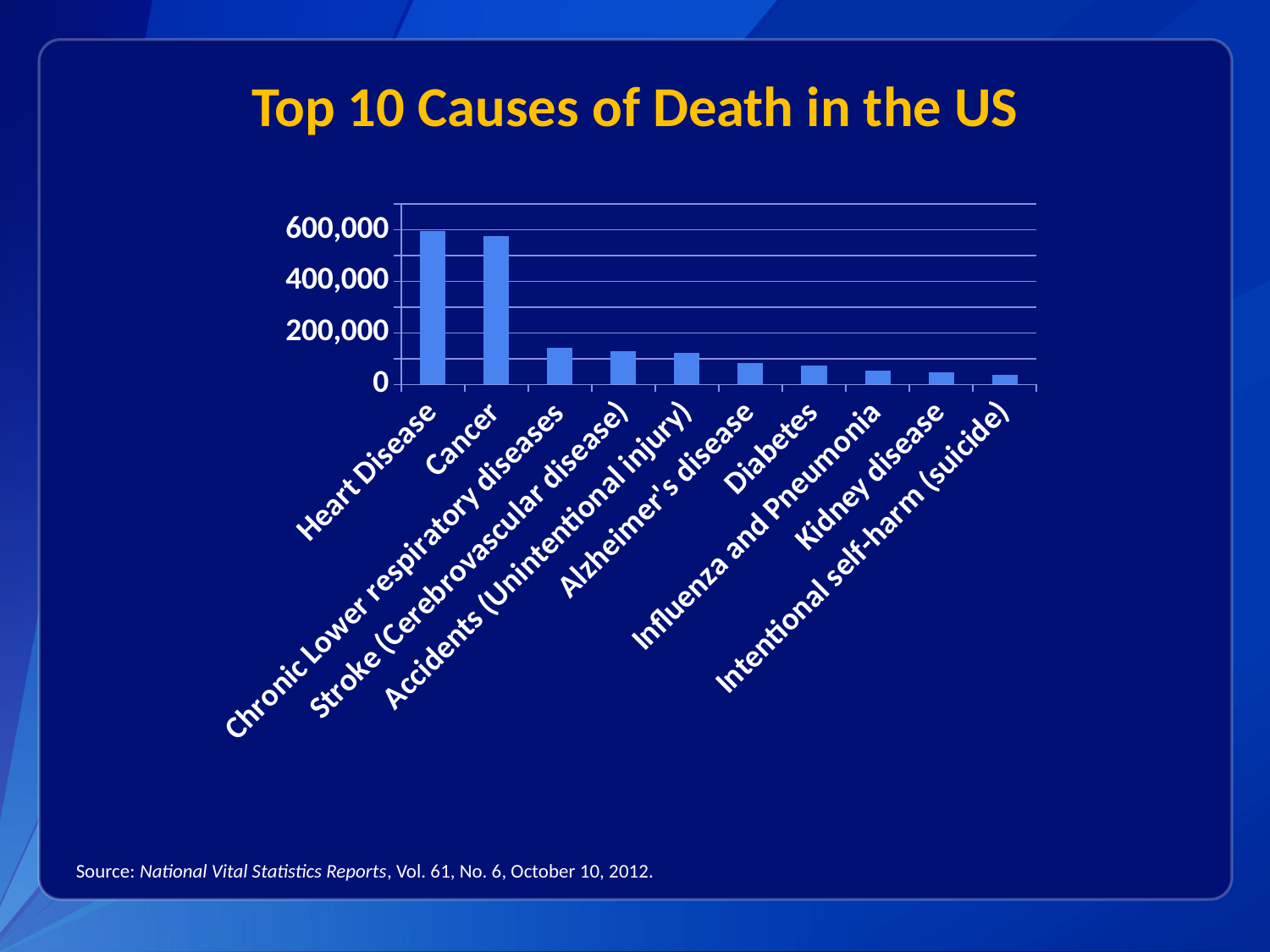
Is the value for Heart Disease greater or less than 400,000? greater Is the value for Alzheimer's disease greater or less than 200,000? less Which is larger, the value for Diabetes or the value for Intentional self-harm (suicide)? Diabetes What is the title of the chart? Top 10 Causes of Death in the US Do the values rise or fall moving from left to right along the x axis? Fall Which cause of death has the highest value on the chart? Heart Disease Is the value for Chronic Lower respiratory diseases greater or less than 200,000? less What kind of chart is shown on the slide? Bar chart Which is larger, the value for Cancer or the value for Stroke (Cerebrovascular disease)? Cancer Which cause of death has the lowest value on the chart? Intentional self-harm (suicide) How many causes of death are plotted on the chart? 10